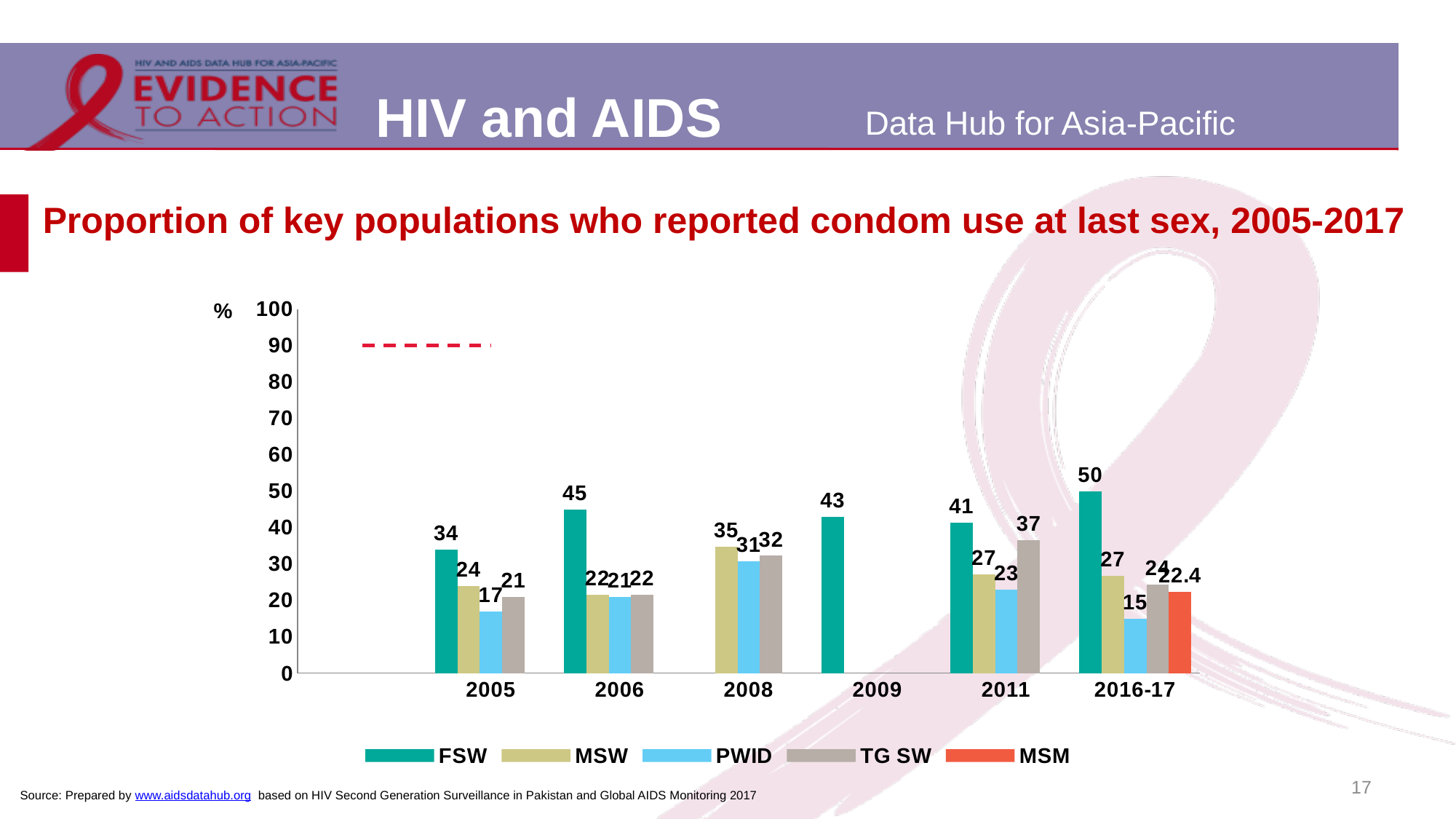
At what level on the y axis is the red dashed line drawn? 90 What is the difference between the FSW value in 2016-17 and the FSW value in 2005? 16 In which year is the PWID value lowest? 2016-17 What is the value for MSM in 2016-17? 22.4 In 2011, which is larger: the TG SW value or the MSW value? TG SW How many series does the legend list? 5 Do the TG SW values rise or fall from 2005 to 2011? Rise How many year categories are shown on the x axis? 6 What kind of chart is shown on the slide? Bar chart What is the value for FSW in 2016-17? 50 What is the value for PWID in 2005? 17 In which year is the FSW value highest? 2016-17